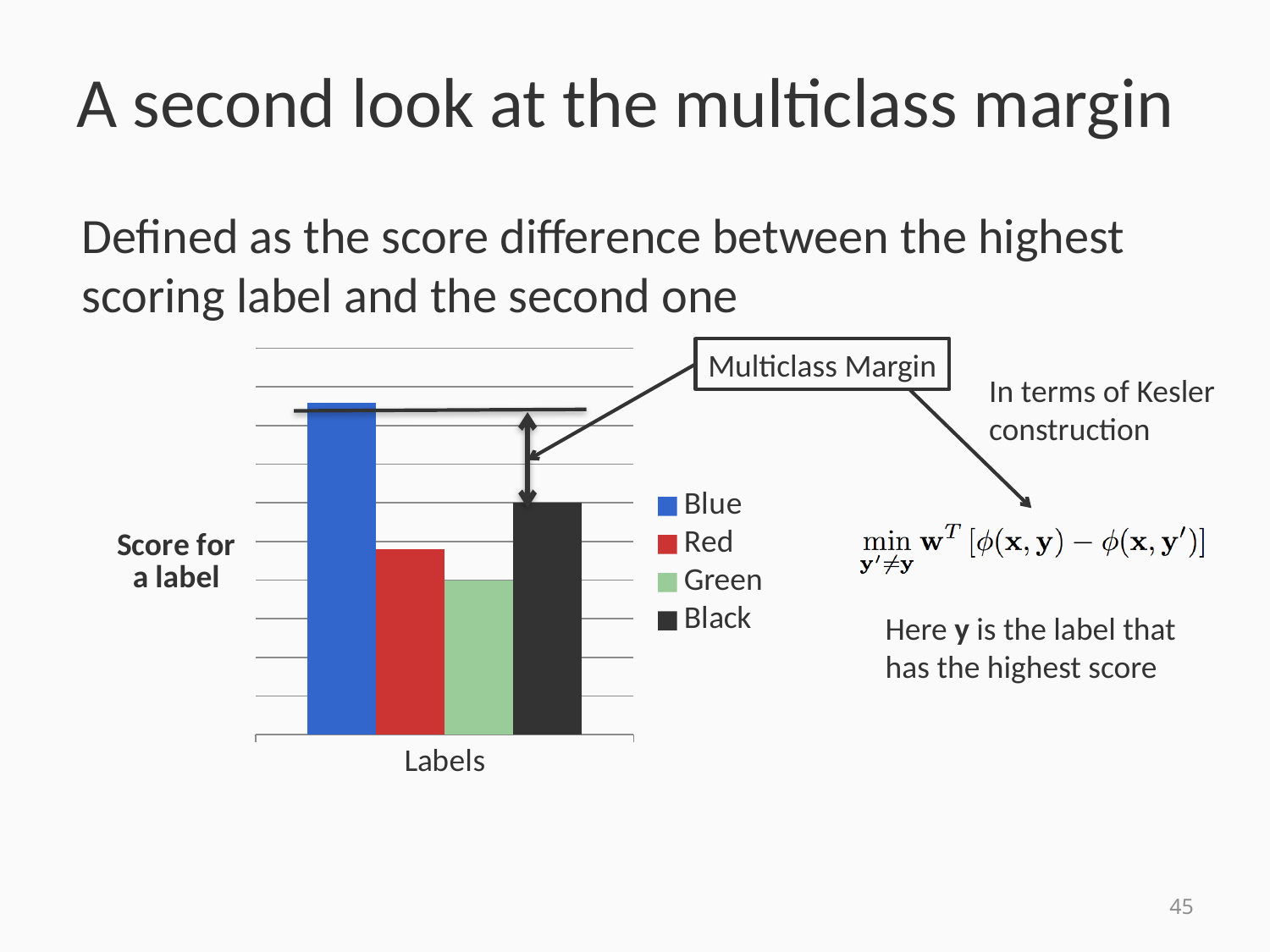
Which label has the lowest score in the bar chart? Green Which label has the highest score in the bar chart? Blue What kind of chart is shown on the slide? bar chart What is the label on the vertical axis of the chart? Score for a label What is the label on the horizontal axis of the chart? Labels Which has a higher score, Red or Black? Black Which has a higher score, Red or Green? Red How many bars are plotted in the chart? 4 How many series does the legend list? 4 Which has a higher score, Blue or Black? Blue Which label has the second highest score in the bar chart? Black